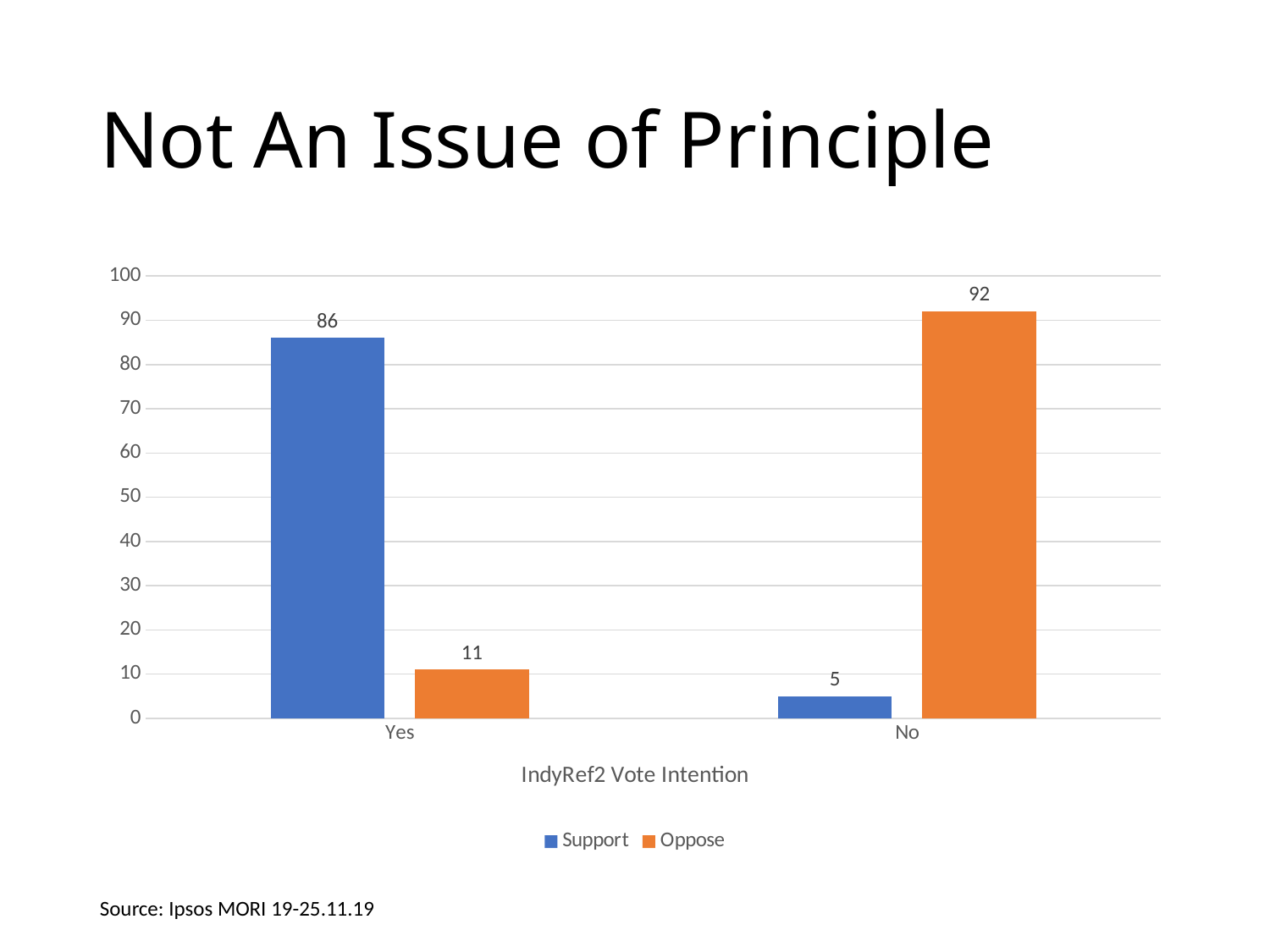
Which category has the highest Oppose value? No What is the Support value for the Yes category? 86 What is the difference between the Support and Oppose values for the Yes category? 75 What is the Oppose value for the Yes category? 11 How many categories are shown on the x axis? 2 What is the Oppose value for the No category? 92 Which is larger for the No category, Support or Oppose? Oppose What is the Support value for the No category? 5 What kind of chart is shown on the slide? Bar chart What is the difference between the Oppose value for No and the Support value for Yes? 6 How many series does the legend list? 2 Which category has the lowest Support value? No